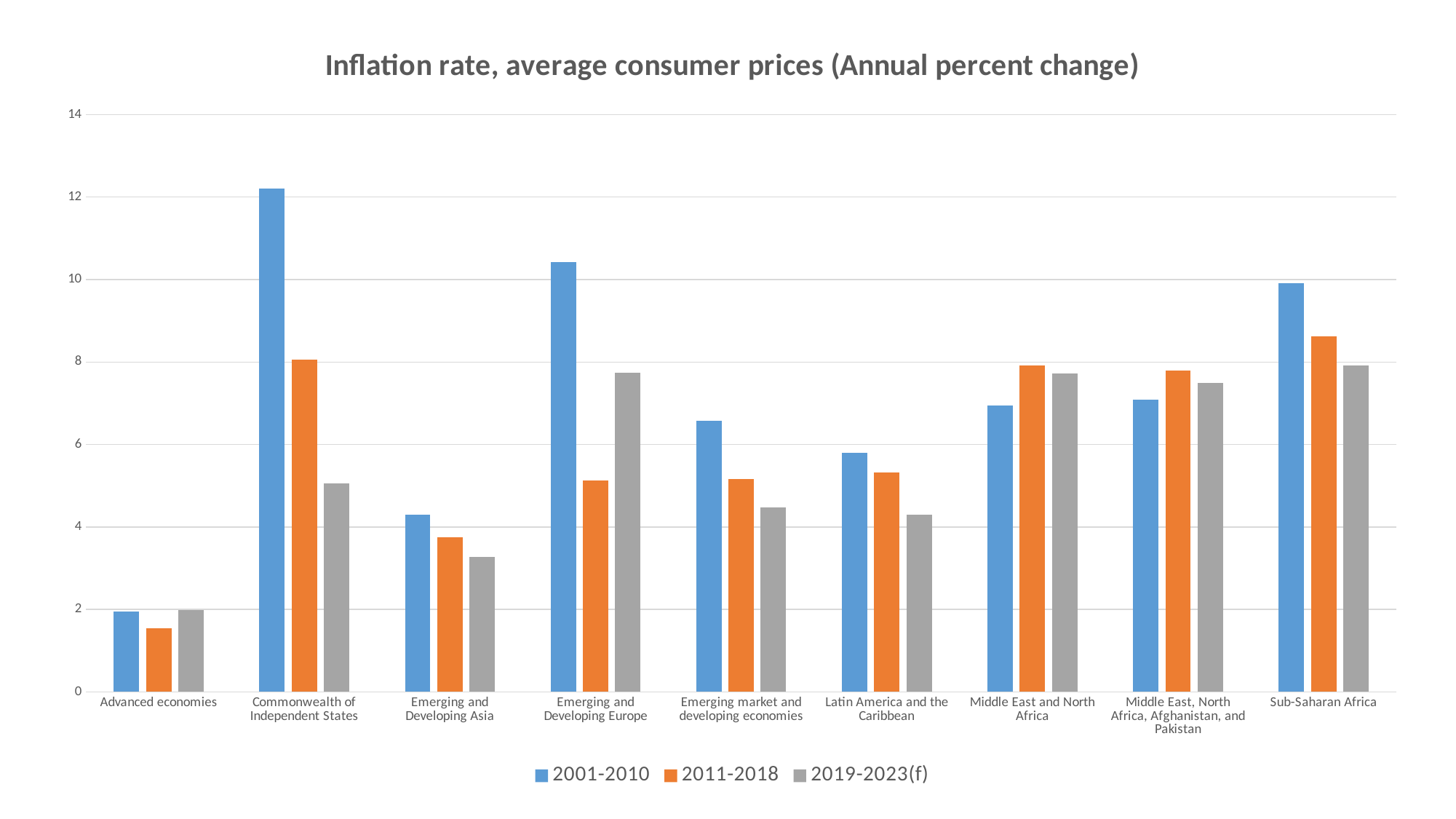
For Advanced economies, which is larger: the 2011-2018 value or the 2019-2023(f) value? 2019-2023(f) For 2001-2010, which is larger: Emerging and Developing Europe or Sub-Saharan Africa? Emerging and Developing Europe What kind of chart is shown on the slide? bar chart Is the 2001-2010 value for Commonwealth of Independent States greater or less than 10? greater What is the title of the chart? Inflation rate, average consumer prices (Annual percent change) Which region has the lowest value for 2019-2023(f)? Advanced economies Is the 2019-2023(f) value for Emerging and Developing Europe greater or less than 6? greater How many regions (categories) are shown on the x axis? 9 Which region has the lowest value for 2011-2018? Advanced economies Which region has the highest value for 2001-2010? Commonwealth of Independent States Is the 2001-2010 value for Emerging market and developing economies greater or less than 6? greater How many series does the legend list? 3